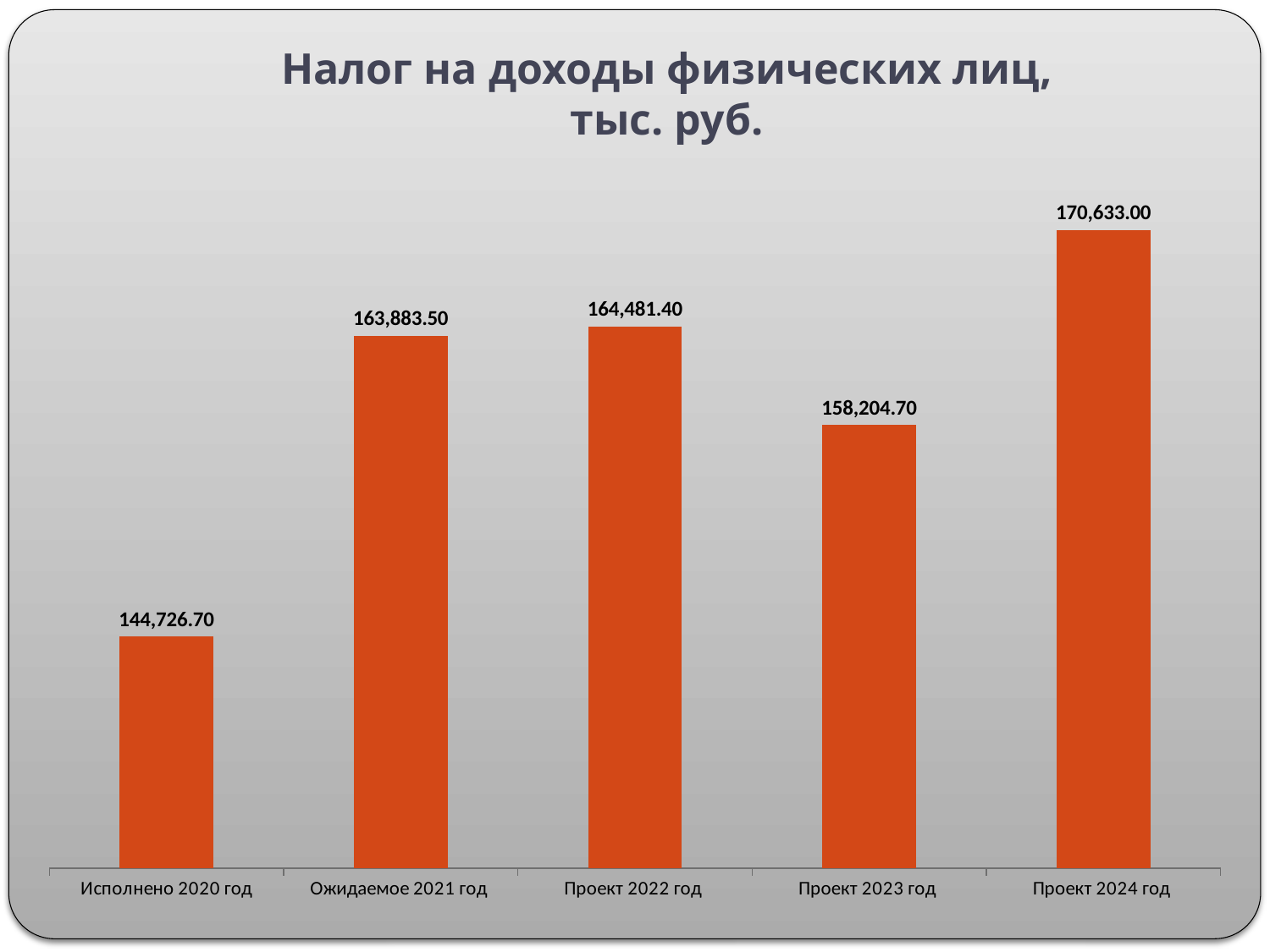
Which category has the highest value? Проект 2024 год What is the value for Ожидаемое 2021 год? 163,883.50 How many categories are shown on the x axis? 5 What is the value for Проект 2023 год? 158,204.70 Which category has the lowest value? Исполнено 2020 год What is the value for Исполнено 2020 год? 144,726.70 What is the difference between the values for Проект 2024 год and Исполнено 2020 год? 25,906.30 Which is larger, the value for Проект 2023 год or the value for Ожидаемое 2021 год? Ожидаемое 2021 год What is the value for Проект 2022 год? 164,481.40 What kind of chart is shown on the slide? Bar chart What is the value for Проект 2024 год? 170,633.00 What is the difference between the values for Проект 2022 год and Проект 2023 год? 6,276.70